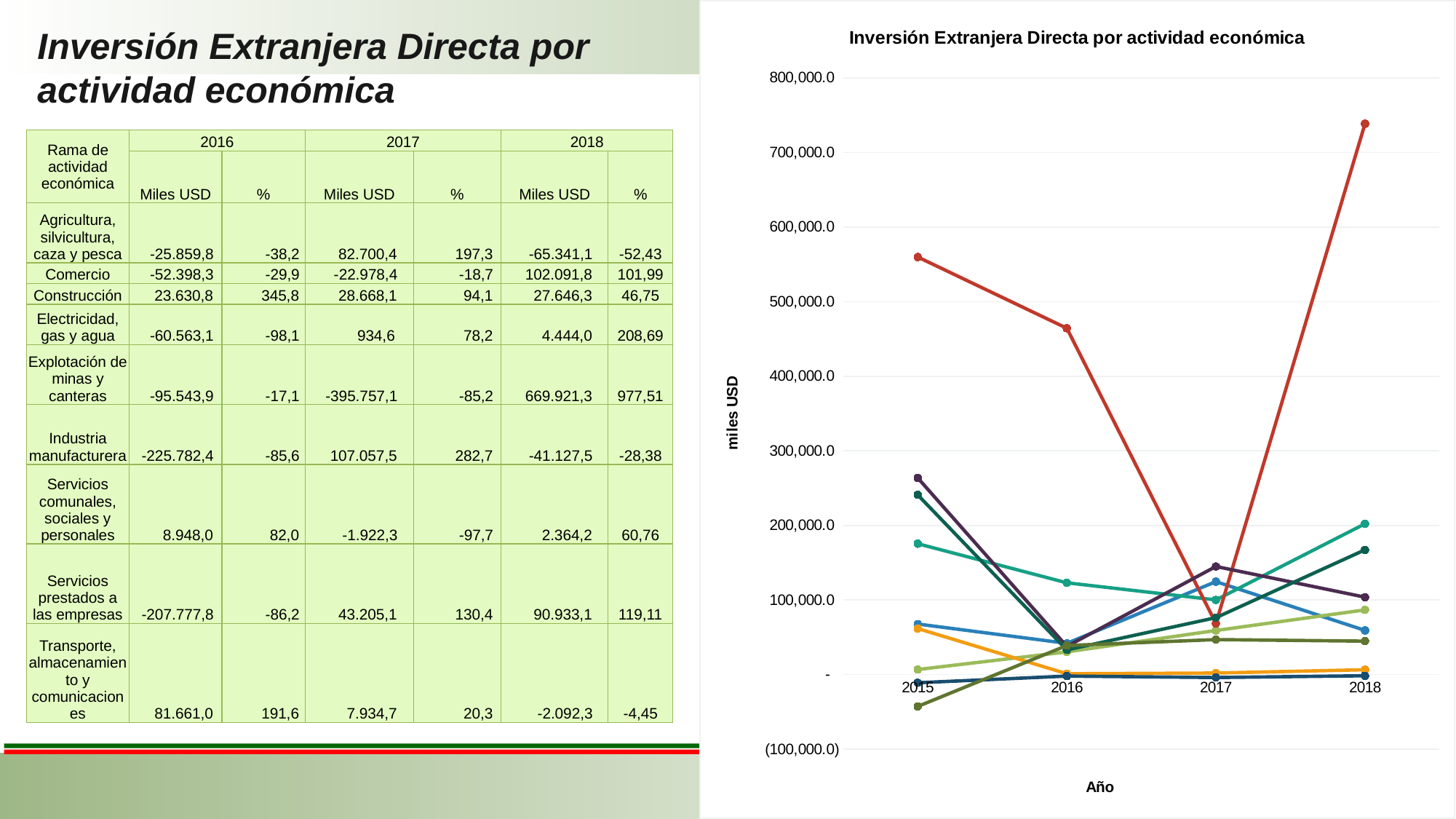
Is the value of the red line in 2016 greater or less than 400,000.0? greater In which year does the red line reach its lowest value? 2017 Is the value of the red line in 2015 greater or less than 500,000.0? greater Does the red line rise or fall from 2015 to 2017? fall Is the value of the red line in 2018 greater or less than 700,000.0? greater In which year does the red line reach its highest value? 2018 What label is shown on the vertical axis of the chart? miles USD What kind of chart is shown on the slide? line chart What is the title of the chart? Inversión Extranjera Directa por actividad económica How many years are plotted along the x axis of the chart? 4 Which is larger in 2018, the value of the red line or the value of the teal line? the red line